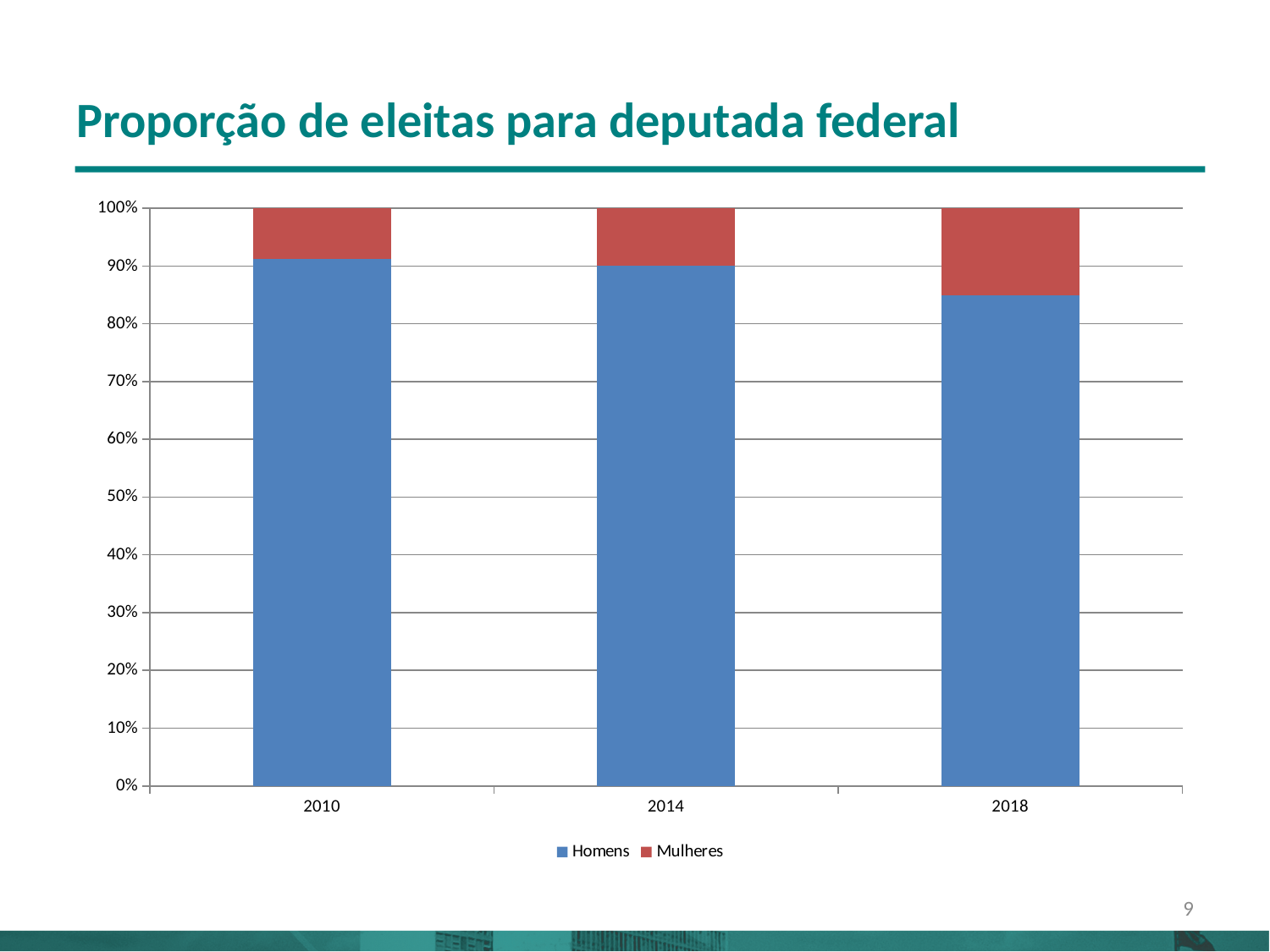
In which year is the Homens share the lowest? 2018 How many series does the legend list? 2 How many years are shown on the x axis? 3 Is the Homens share in 2018 greater or less than 90%? less In which year is the Mulheres share the highest? 2018 Which is larger, the Homens share in 2010 or in 2018? 2010 What kind of chart is shown on the slide? bar chart Which series is shown in red? Mulheres What is the title of the chart? Proporção de eleitas para deputada federal Does the Mulheres share rise or fall from 2010 to 2018? rise Is the Homens share in 2018 greater or less than 80%? greater Is the Mulheres share in 2018 greater or less than 10%? greater